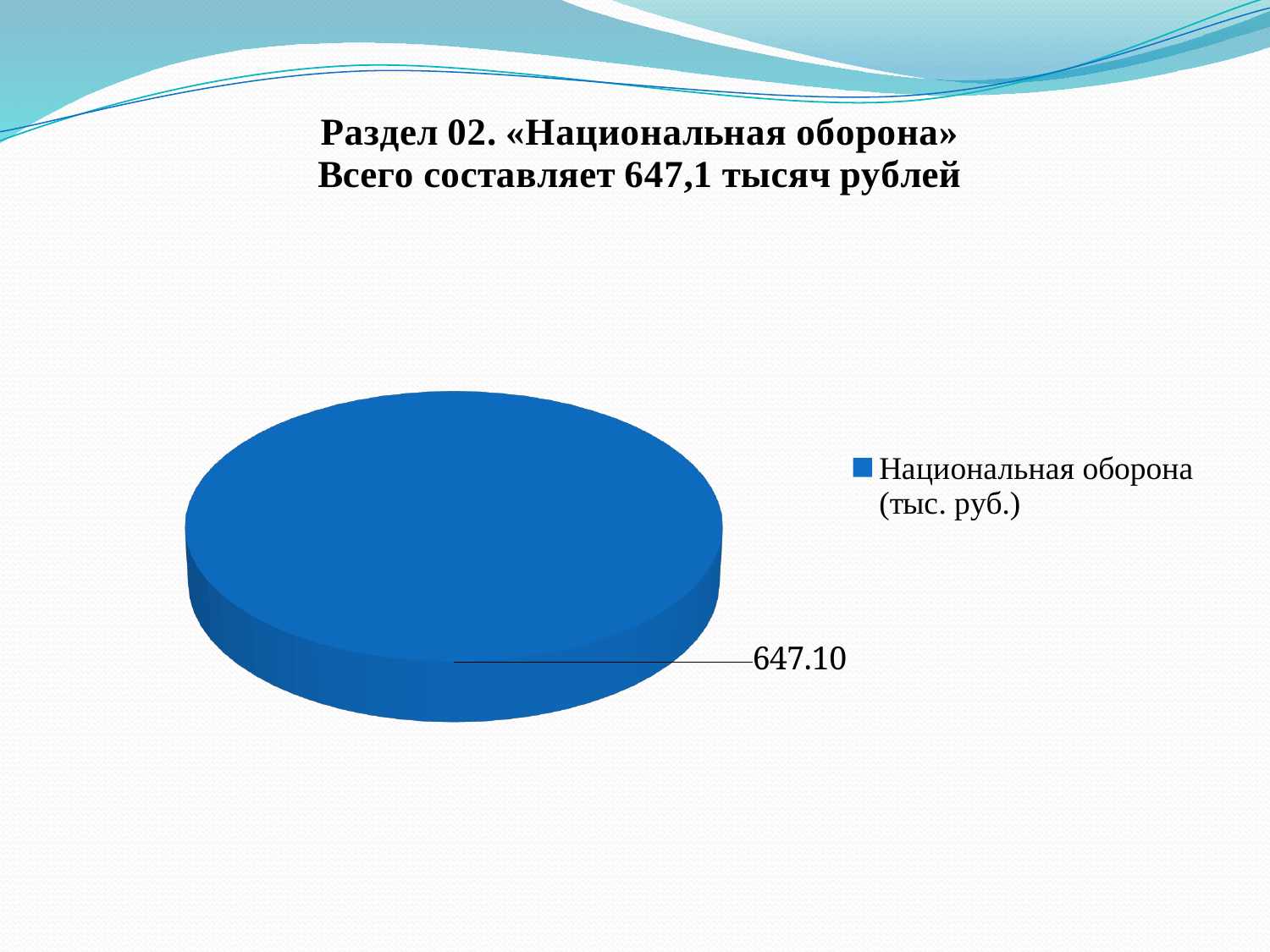
What share of the pie does the Национальная оборона (тыс. руб.) slice take up? 100% What is the value for Национальная оборона (тыс. руб.) on the pie chart? 647.10 How many slices does the pie chart have? 1 What is the legend entry shown next to the pie chart? Национальная оборона (тыс. руб.) How many entries does the legend of the pie chart list? 1 What value is shown by the data label on the pie chart? 647.10 What kind of chart is shown on the slide? pie chart What colour is the slice of the pie chart? blue